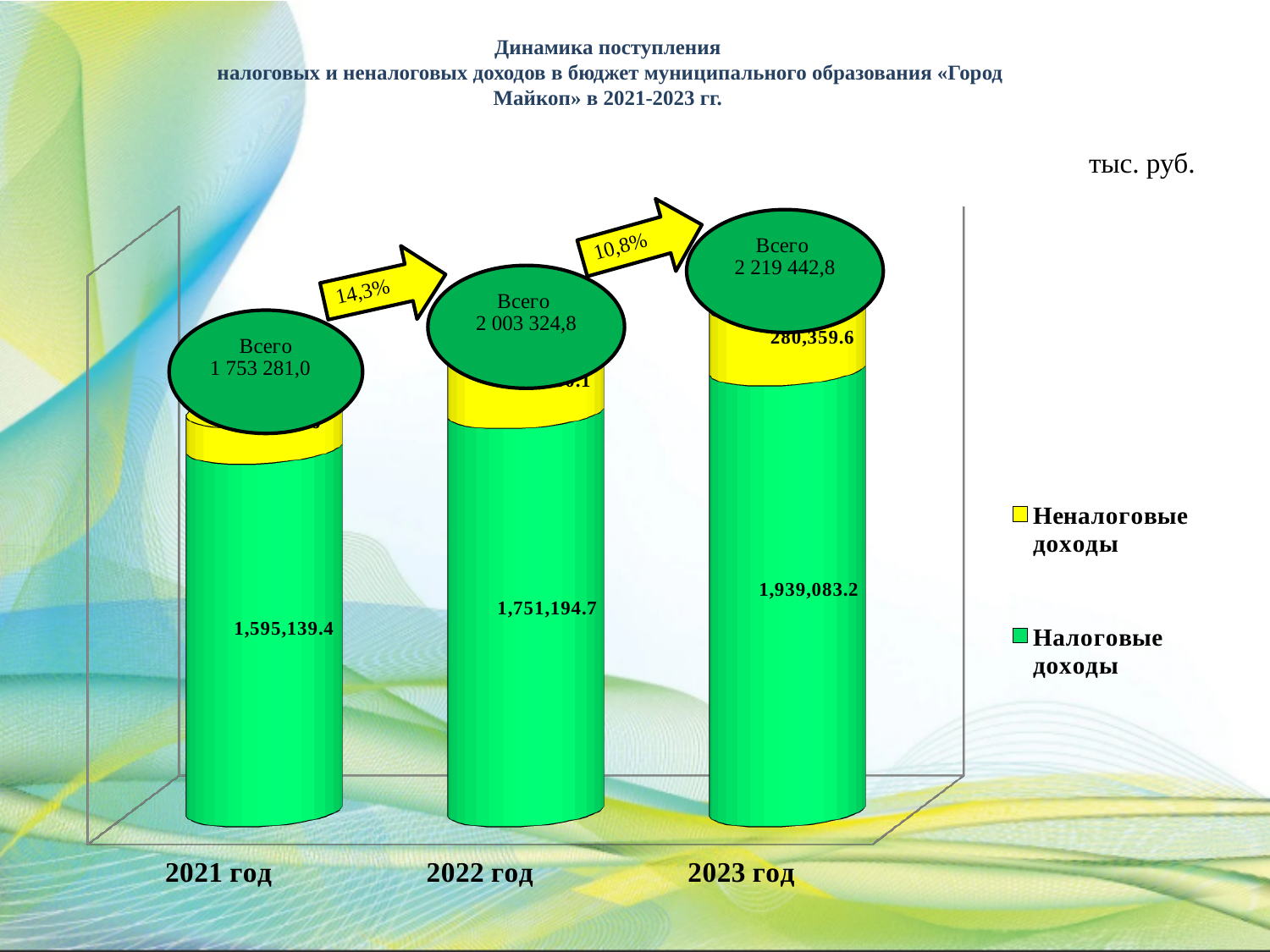
Which year has the highest value of Налоговые доходы? 2023 год What growth percentage is shown on the arrow between 2021 год and 2022 год? 14,3% How many years (categories) are shown on the x axis? 3 What is the difference between Налоговые доходы in 2023 год and 2022 год? 187,888.5 What kind of chart is shown on the slide? Stacked bar chart What is the value of Налоговые доходы for 2021 год? 1,595,139.4 What is the value of Неналоговые доходы for 2023 год? 280,359.6 What total (Всего) is shown for 2021 год? 1 753 281,0 How many series does the legend list? 2 What is the value of Налоговые доходы for 2023 год? 1,939,083.2 What is the value of Налоговые доходы for 2022 год? 1,751,194.7 What total (Всего) is shown for 2023 год? 2 219 442,8